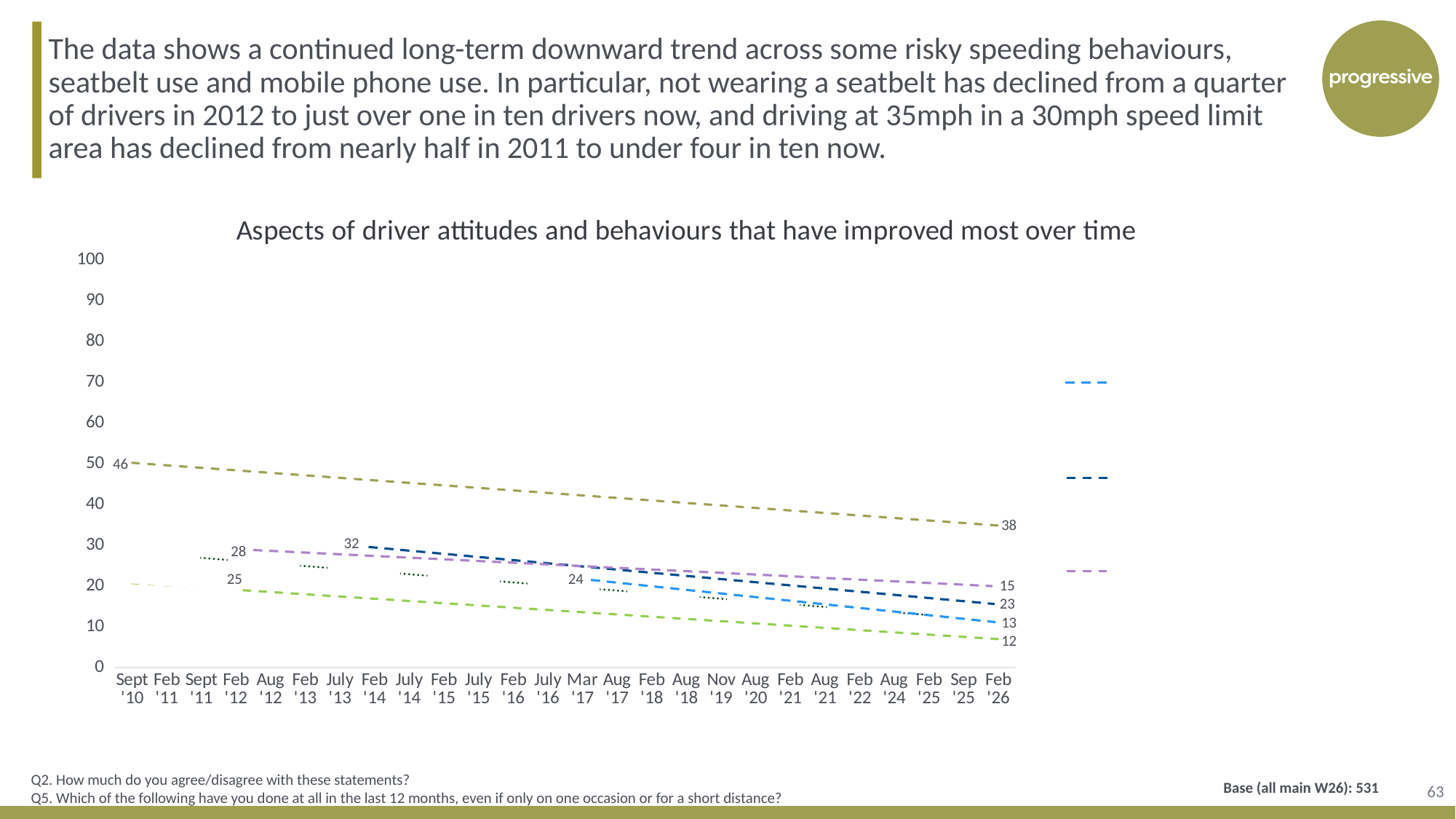
What value is labelled on the olive dashed line at Feb '26? 38 By how much does the olive dashed line fall from its labelled value at Sept '10 to its labelled value at Feb '26? 8 What type of chart is shown on the slide? Line chart Does the olive dashed line rise or fall from Sept '10 to Feb '26? Fall Which is the highest value labelled at Feb '26? 38 What value is labelled on the dark blue dashed line at Feb '14? 32 What value is labelled on the green dashed line at Feb '26? 12 What value is labelled on the purple dashed line at Feb '12? 28 At Feb '26, which is larger: the dark blue dashed line (23) or the light blue dashed line (13)? The dark blue dashed line What is the title of the chart? Aspects of driver attitudes and behaviours that have improved most over time What value is labelled on the olive dashed line at Sept '10? 46 Which is the lowest value labelled at Feb '26? 12